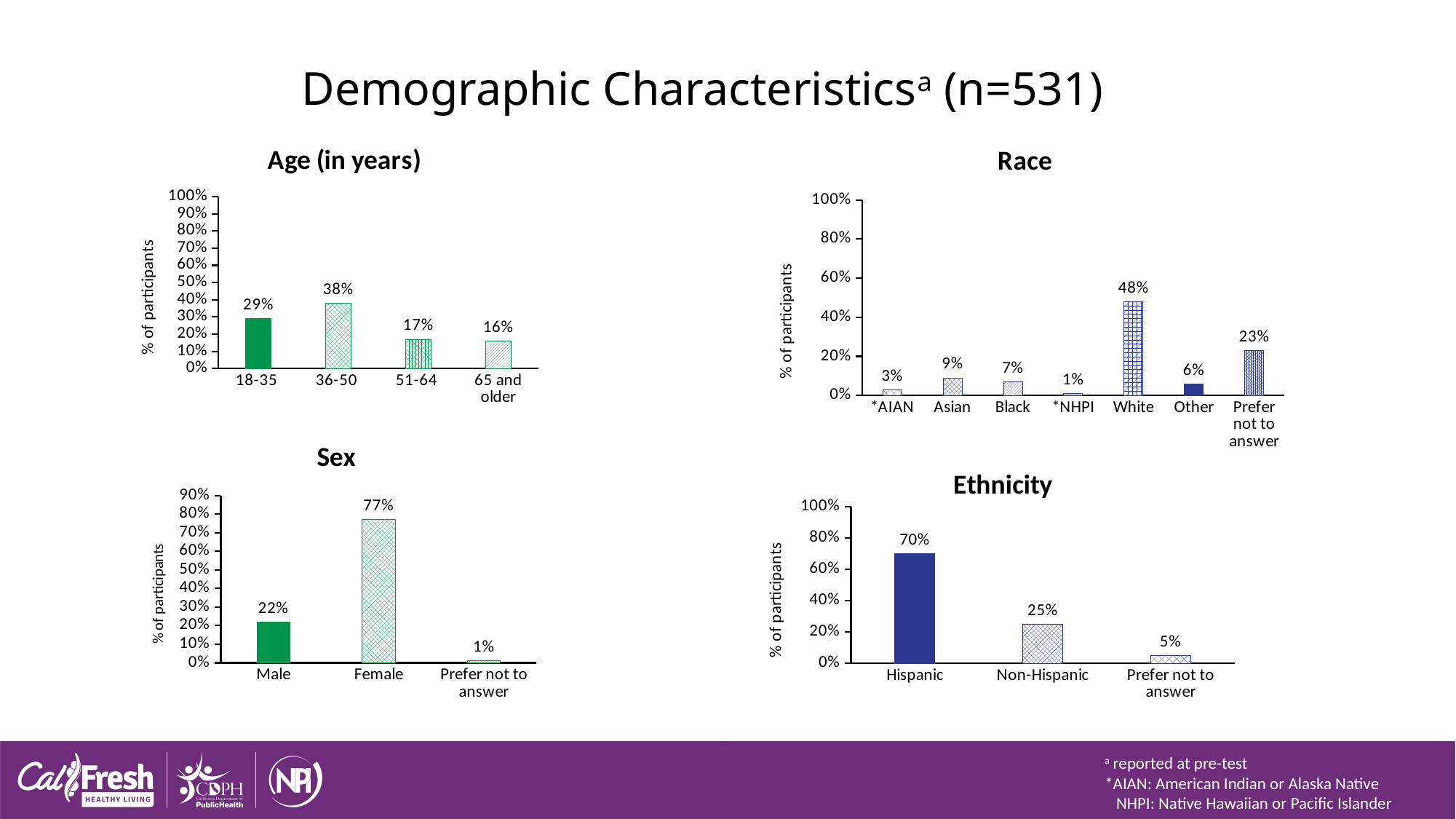
In the Race chart, which category has the lowest percentage? *NHPI In the Race chart, which is larger, Asian or Black? Asian In the Sex chart, what percentage of participants are Female? 77% In the Ethnicity chart, what percentage of participants are Non-Hispanic? 25% In the Age (in years) chart, what is the difference between the 18-35 and 51-64 percentages? 12% In the Race chart, how many race categories are shown? 7 In the Age (in years) chart, what percentage of participants are aged 36-50? 38% In the Race chart, what percentage of participants are White? 48% What type of chart is the Ethnicity chart? Bar chart In the Ethnicity chart, which category has the highest percentage? Hispanic In the Age (in years) chart, which age group has the lowest percentage of participants? 65 and older In the Sex chart, what is the difference between the Female and Male percentages? 55%